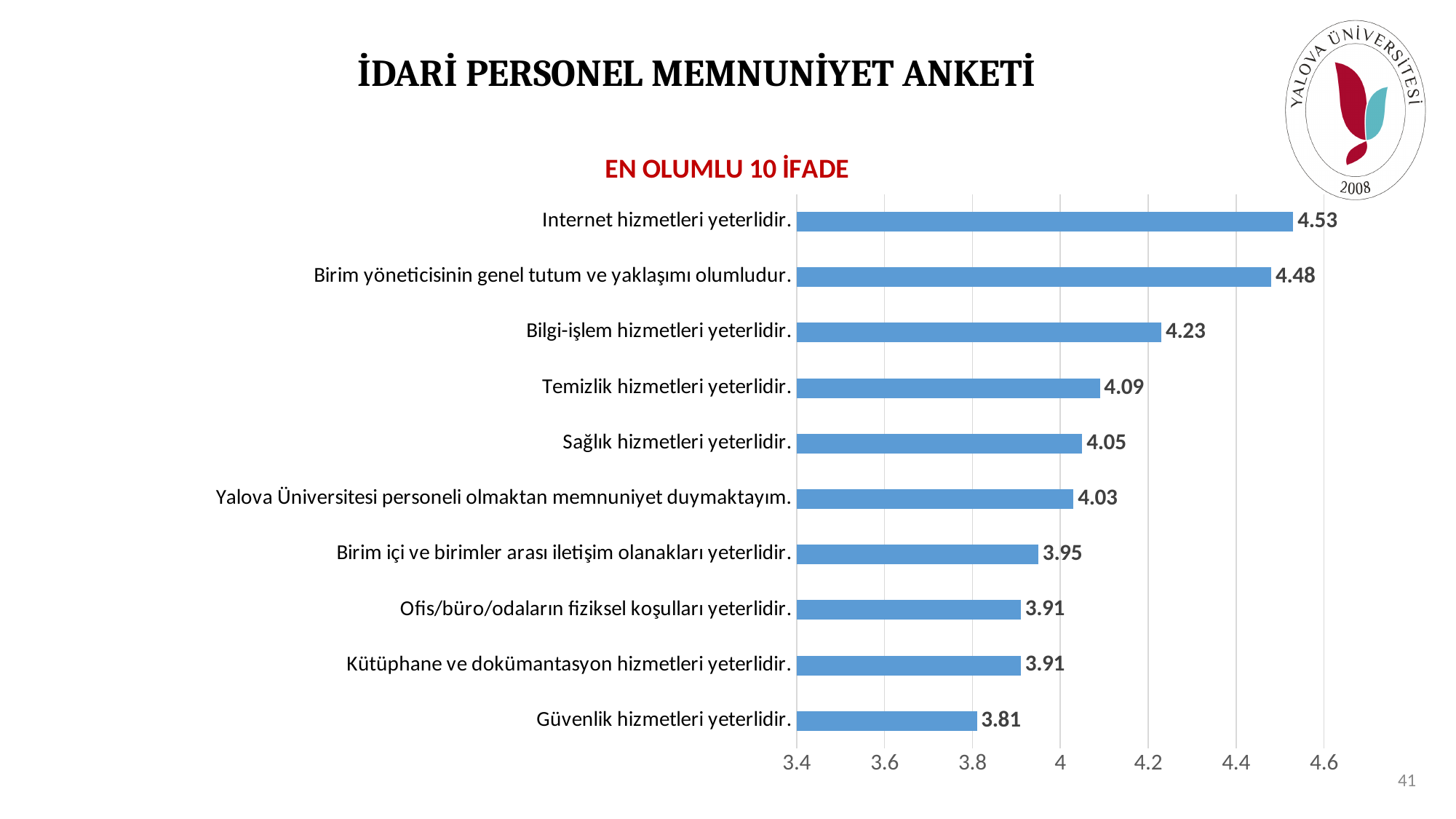
How many statements are shown in the chart? 10 What is the difference between the values for "Bilgi-işlem hizmetleri yeterlidir." and "Sağlık hizmetleri yeterlidir."? 0.18 Which has a larger value, "Birim yöneticisinin genel tutum ve yaklaşımı olumludur." or "Bilgi-işlem hizmetleri yeterlidir."? Birim yöneticisinin genel tutum ve yaklaşımı olumludur. Which statement has the lowest value? Güvenlik hizmetleri yeterlidir. What is the difference between the values for "Internet hizmetleri yeterlidir." and "Güvenlik hizmetleri yeterlidir."? 0.72 What is the title of the chart? EN OLUMLU 10 İFADE Is the value for "Birim içi ve birimler arası iletişim olanakları yeterlidir." greater or less than 4? less What is the value for "Temizlik hizmetleri yeterlidir."? 4.09 What is the value for "Güvenlik hizmetleri yeterlidir."? 3.81 What kind of chart is shown on the slide? bar chart What is the value for "Internet hizmetleri yeterlidir."? 4.53 Which statement has the highest value? Internet hizmetleri yeterlidir.